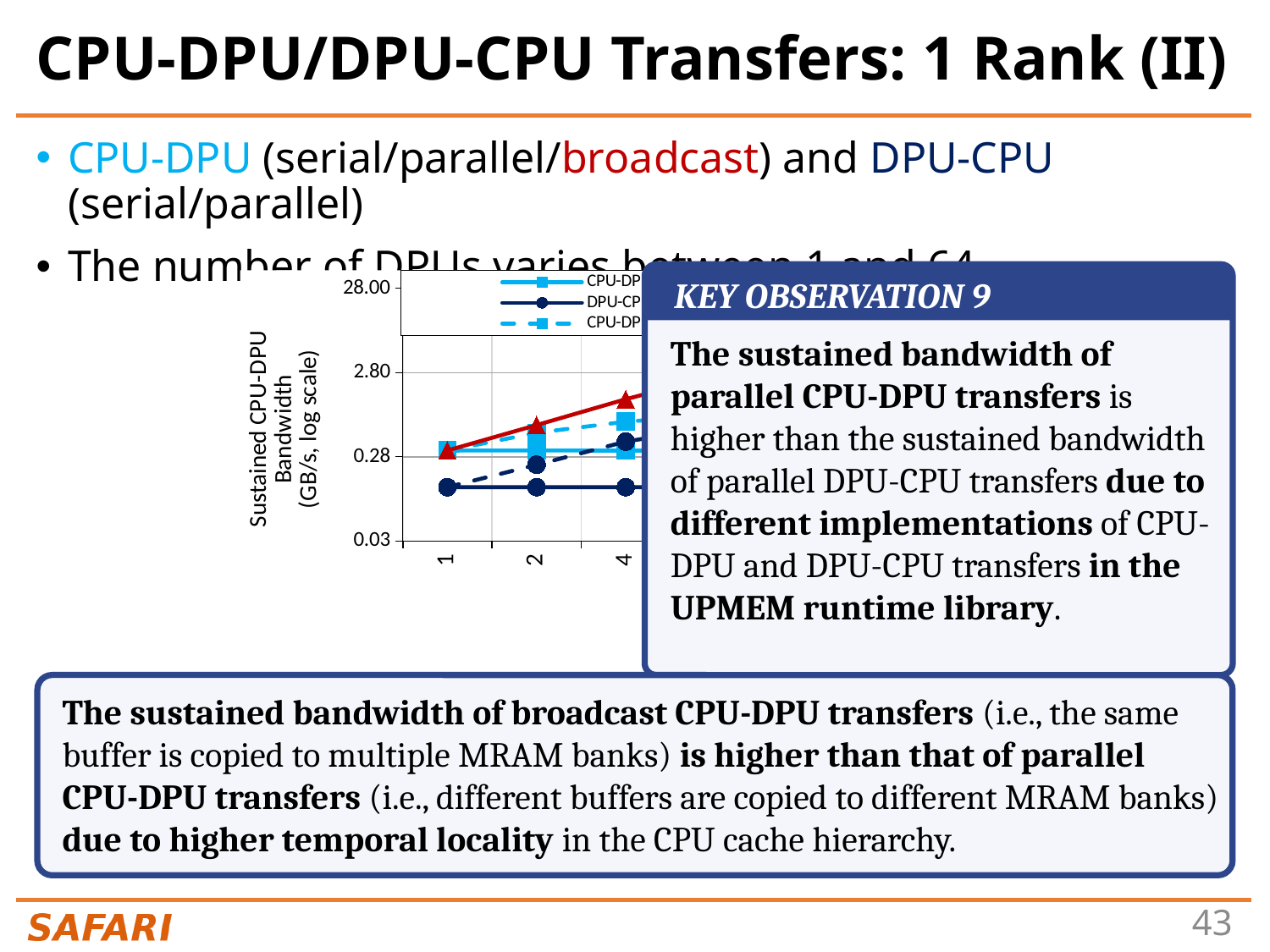
What is the highest tick value shown on the chart's y-axis? 28.00 Is the value of the red line with triangle markers at x = 4 greater or less than 0.28? greater What kind of chart is shown on the slide? line chart At x = 1, which is higher: the solid light blue line with square markers or the solid dark blue line with circle markers? the solid light blue line with square markers At x = 4, which is higher: the red line with triangle markers or the solid dark blue line with circle markers? the red line with triangle markers What is the label on the y-axis of the chart? Sustained CPU-DPU Bandwidth (GB/s, log scale) Does the red line with triangle markers rise or fall as the number of DPUs increases from 1 to 4? rise Does the dashed dark blue line with circle markers rise or fall from x = 1 to x = 4? rise Is the value of the solid dark blue line with circle markers at x = 1 greater or less than 0.28? less Is the value of the red line with triangle markers at x = 4 greater or less than 2.80? less